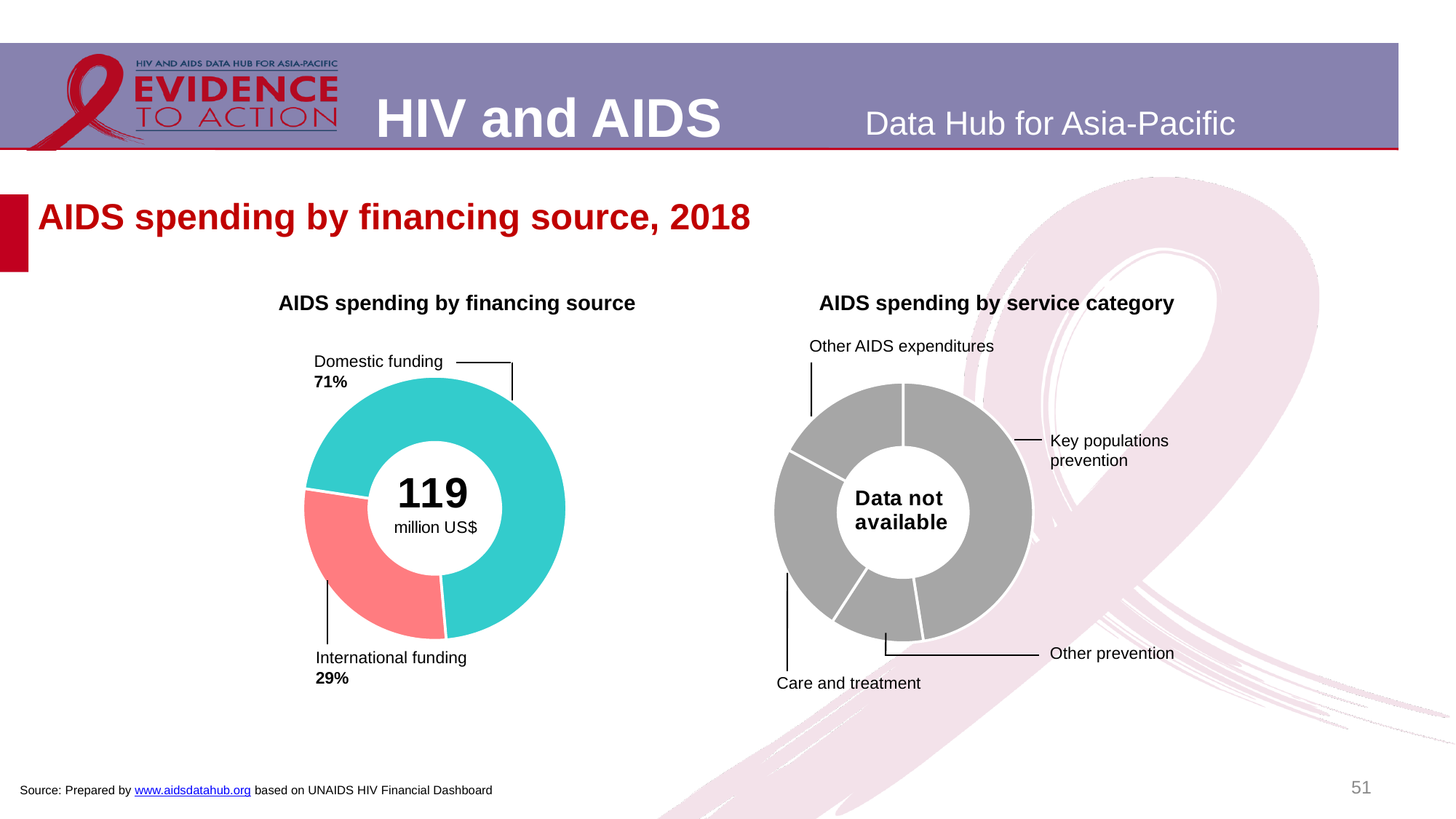
In the 'AIDS spending by financing source' chart, what total amount is shown in the centre of the donut? 119 million US$ In the 'AIDS spending by financing source' chart, which is larger: domestic funding or international funding? Domestic funding In the 'AIDS spending by financing source' chart, what share of spending comes from domestic funding? 71% How many service categories are labelled in the 'AIDS spending by service category' chart? 4 In the 'AIDS spending by financing source' chart, what is the difference in percentage points between domestic and international funding? 42 percentage points In the 'AIDS spending by financing source' chart, which financing source has the largest share? Domestic funding In the 'AIDS spending by financing source' chart, what colour is the domestic funding segment? Teal How many categories does the 'AIDS spending by financing source' chart show? 2 In the 'AIDS spending by financing source' chart, what share of spending comes from international funding? 29% What kind of chart is the 'AIDS spending by financing source' chart? Donut (pie) chart What text appears in the centre of the 'AIDS spending by service category' chart? Data not available In the 'AIDS spending by financing source' chart, which financing source has the smallest share? International funding